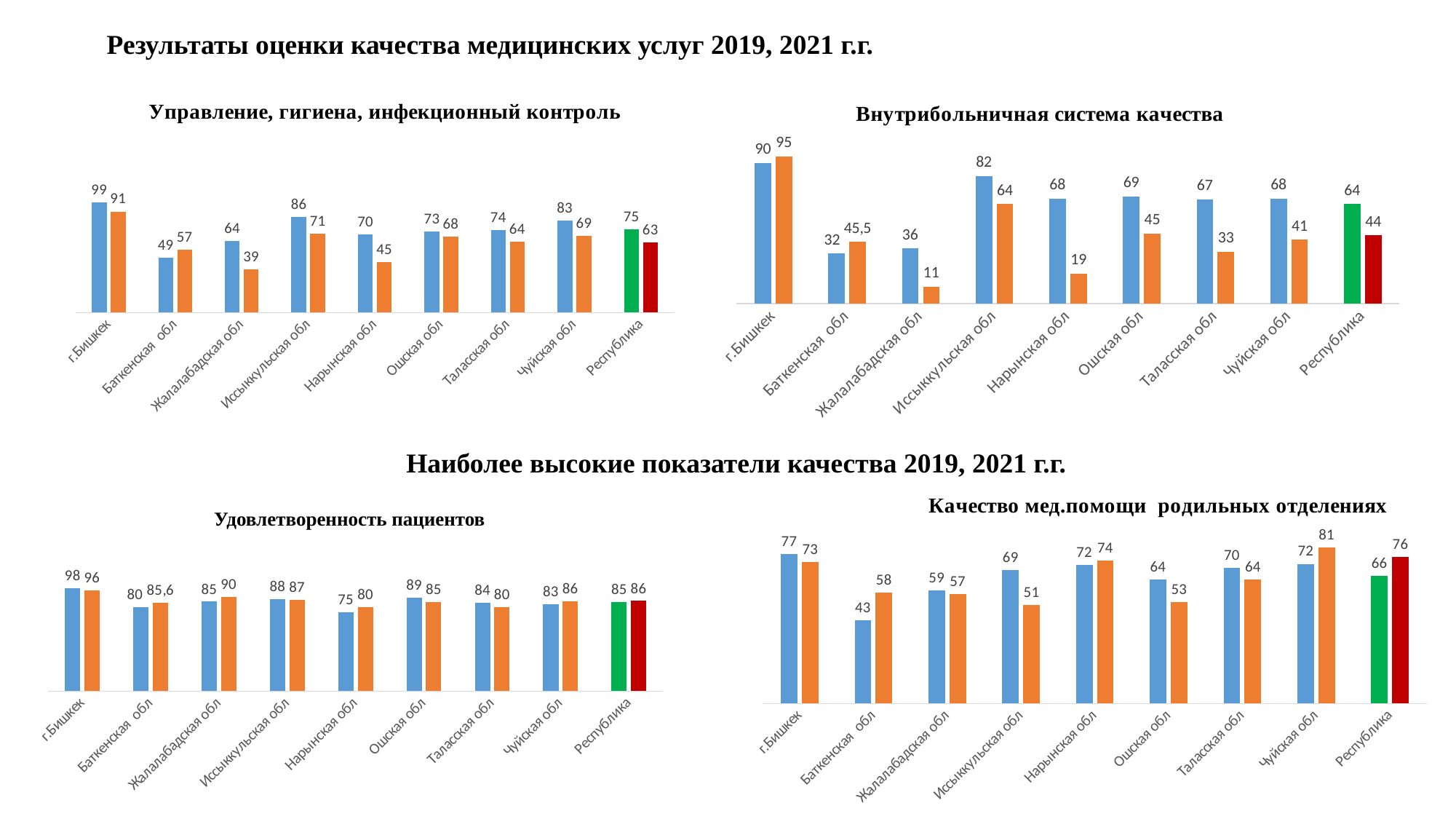
In the chart titled "Внутрибольничная система качества", which category has the lowest orange bar? Жалалабадская обл What type of chart is the chart titled "Внутрибольничная система качества"? bar chart In the chart titled "Удовлетворенность пациентов", what is the value of the orange bar for Баткенская обл? 85,6 In the chart titled "Внутрибольничная система качества", what is the difference between the blue bar and the orange bar for Нарынская обл? 49 In the chart titled "Управление, гигиена, инфекционный контроль", which is larger for Баткенская обл: the blue bar or the orange bar? the orange bar How many categories are shown on the x axis of the chart titled "Удовлетворенность пациентов"? 9 In the chart titled "Качество мед.помощи родильных отделениях", what is the value of the red bar for Республика? 76 In the chart titled "Управление, гигиена, инфекционный контроль", what is the value of the blue bar for г.Бишкек? 99 In the chart titled "Качество мед.помощи родильных отделениях", what is the difference between the orange bar and the blue bar for Чуйская обл? 9 In the chart titled "Внутрибольничная система качества", what is the value of the orange bar for Баткенская обл? 45,5 In the chart titled "Удовлетворенность пациентов", which category has the highest blue bar? г.Бишкек How many charts are shown on the slide? 4